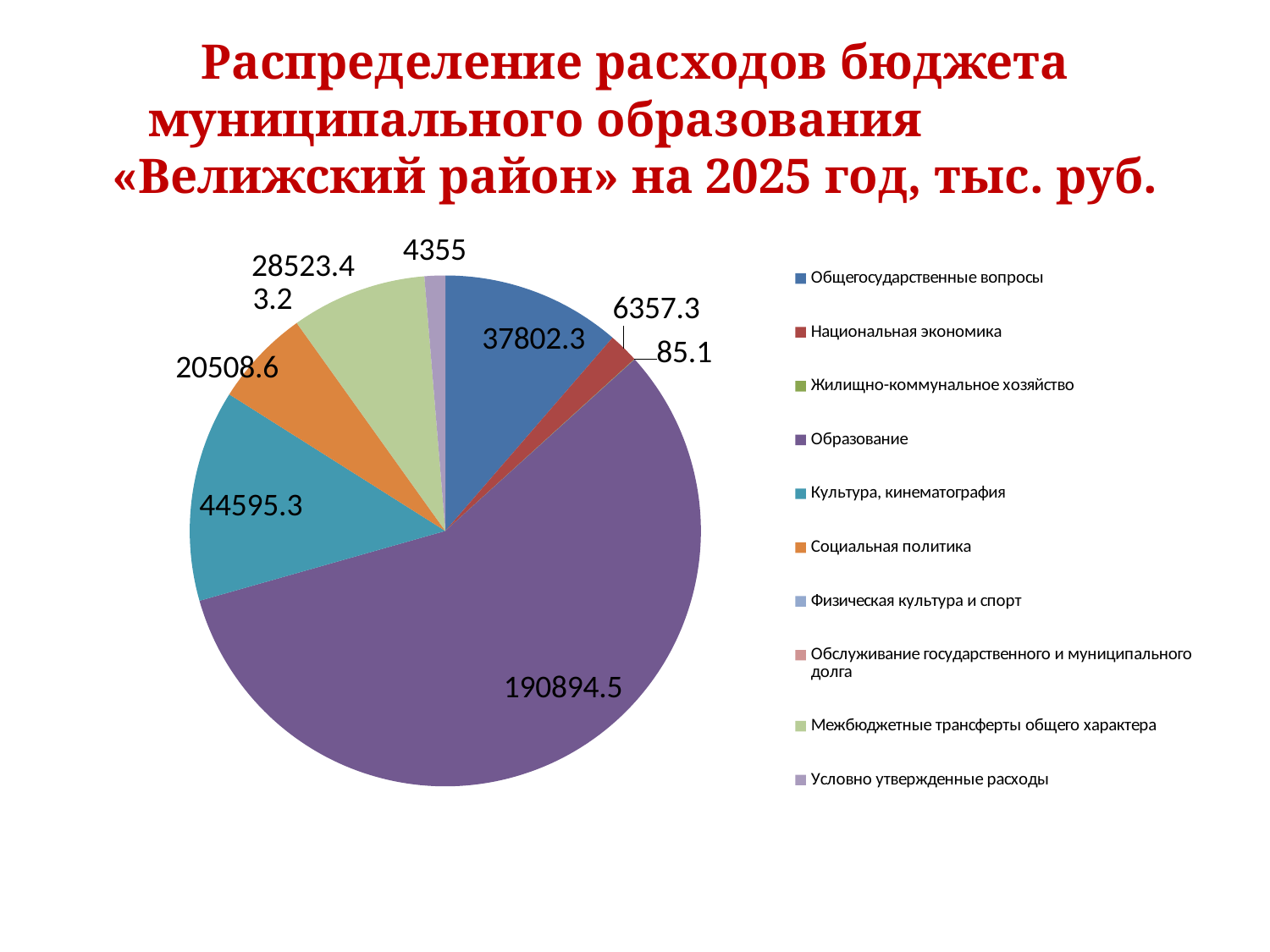
What is the value for Межбюджетные трансферты общего характера? 28523.4 What is the difference between the values for Культура, кинематография and Общегосударственные вопросы? 6793 How many categories does the legend list? 10 Which category has the largest share of the budget expenditures in the pie chart? Образование What is the value for Национальная экономика? 6357.3 What is the value for Культура, кинематография? 44595.3 What is the value for Социальная политика? 20508.6 What is the value for Общегосударственные вопросы? 37802.3 Which is larger: Межбюджетные трансферты общего характера or Социальная политика? Межбюджетные трансферты общего характера What kind of chart is shown on the slide? pie chart What is the value for Образование? 190894.5 What is the value for Условно утвержденные расходы? 4355